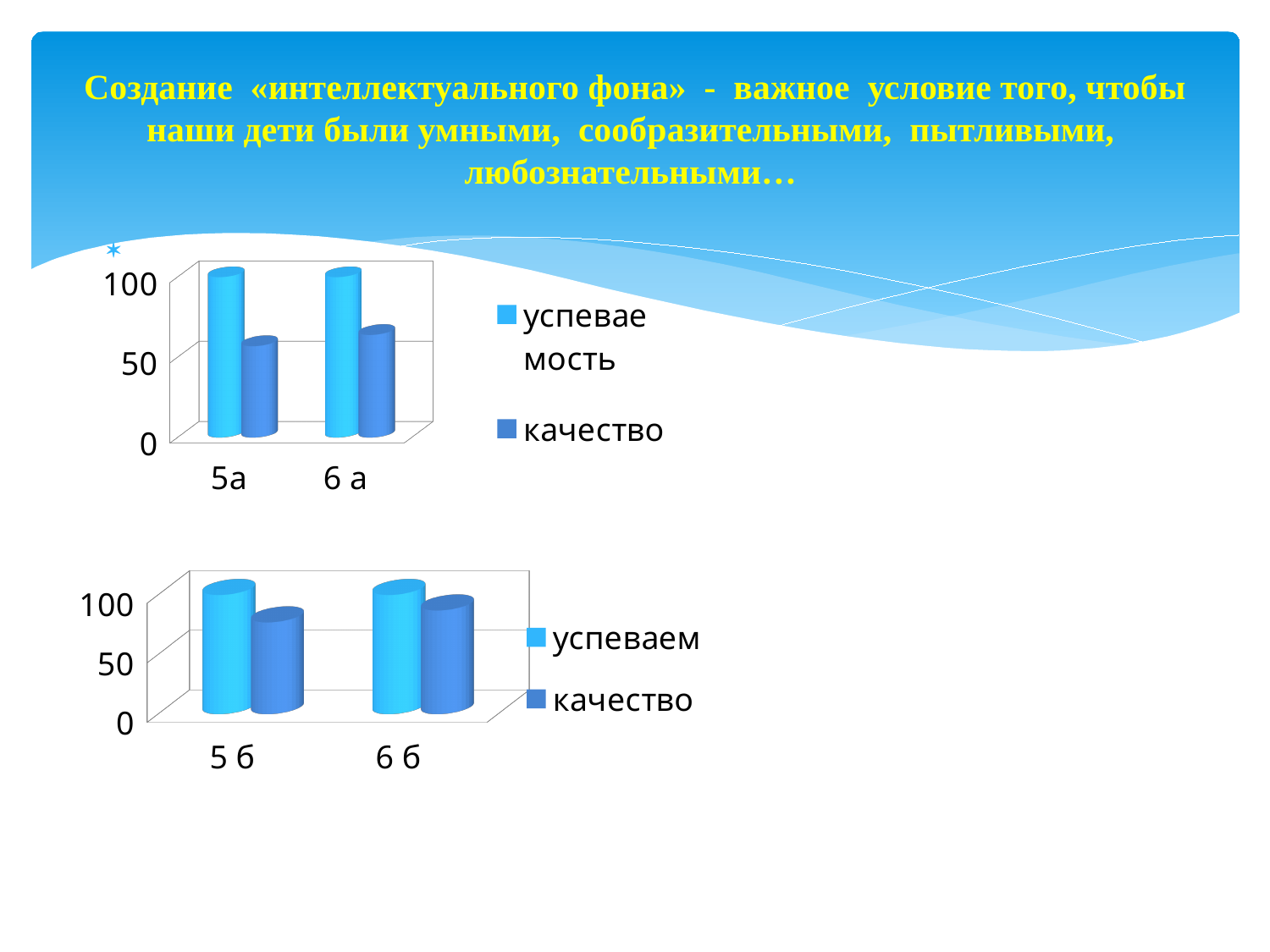
What kind of chart is the top chart on the slide? bar chart In the top chart, which series is larger for 5а, успеваемость or качество? успеваемость In the bottom chart, which category has the larger качество value, 5 б or 6 б? 6 б In the top chart, which category has the larger качество value, 5а or 6 а? 6 а In the bottom chart, is the качество value for 5 б greater or less than 50? greater How many categories are shown on the x axis of the bottom chart? 2 How many series does the legend of the bottom chart list? 2 In the bottom chart, is the качество value for 6 б greater or less than 50? greater How many categories are shown on the x axis of the top chart? 2 In the top chart, is the качество value for 6 а greater or less than 50? greater How many series does the legend of the top chart list? 2 What kind of chart is the bottom chart on the slide? bar chart